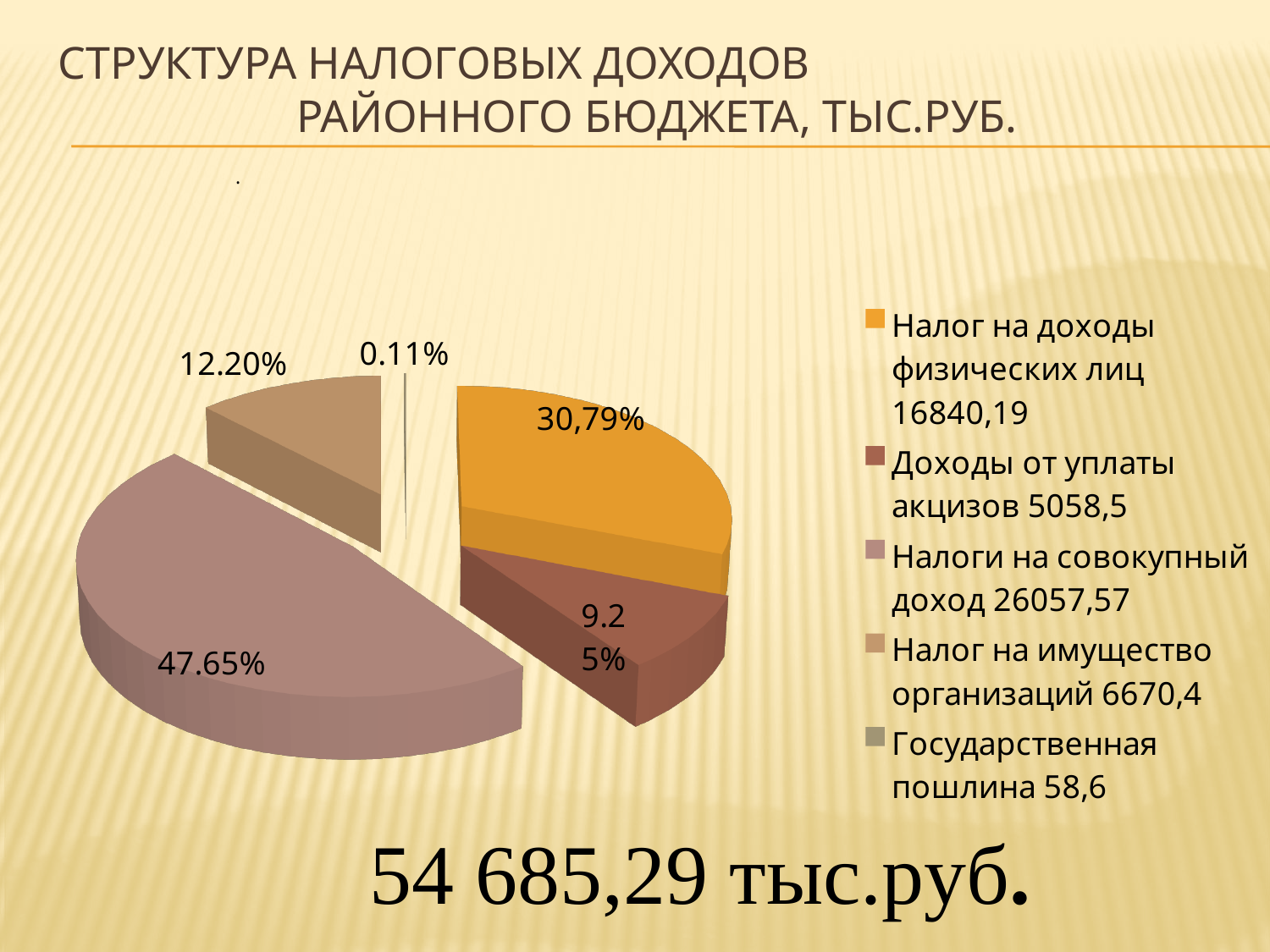
What kind of chart is shown on the slide? pie chart What percentage share is labelled for the slice 'Налоги на совокупный доход'? 47.65% What percentage share is labelled for the slice 'Государственная пошлина'? 0.11% What percentage share is labelled for the slice 'Налог на имущество организаций'? 12.20% How many slices does the pie chart have? 5 Which category has the smallest share of the pie? Государственная пошлина Which category has the largest share of the pie? Налоги на совокупный доход How many entries does the legend list? 5 What total amount in тыс.руб. is printed below the chart? 54 685,29 тыс.руб. What value (тыс.руб.) does the legend give for 'Доходы от уплаты акцизов'? 5058,5 Which is larger: the share for 'Налог на доходы физических лиц' or the share for 'Налог на имущество организаций'? Налог на доходы физических лиц